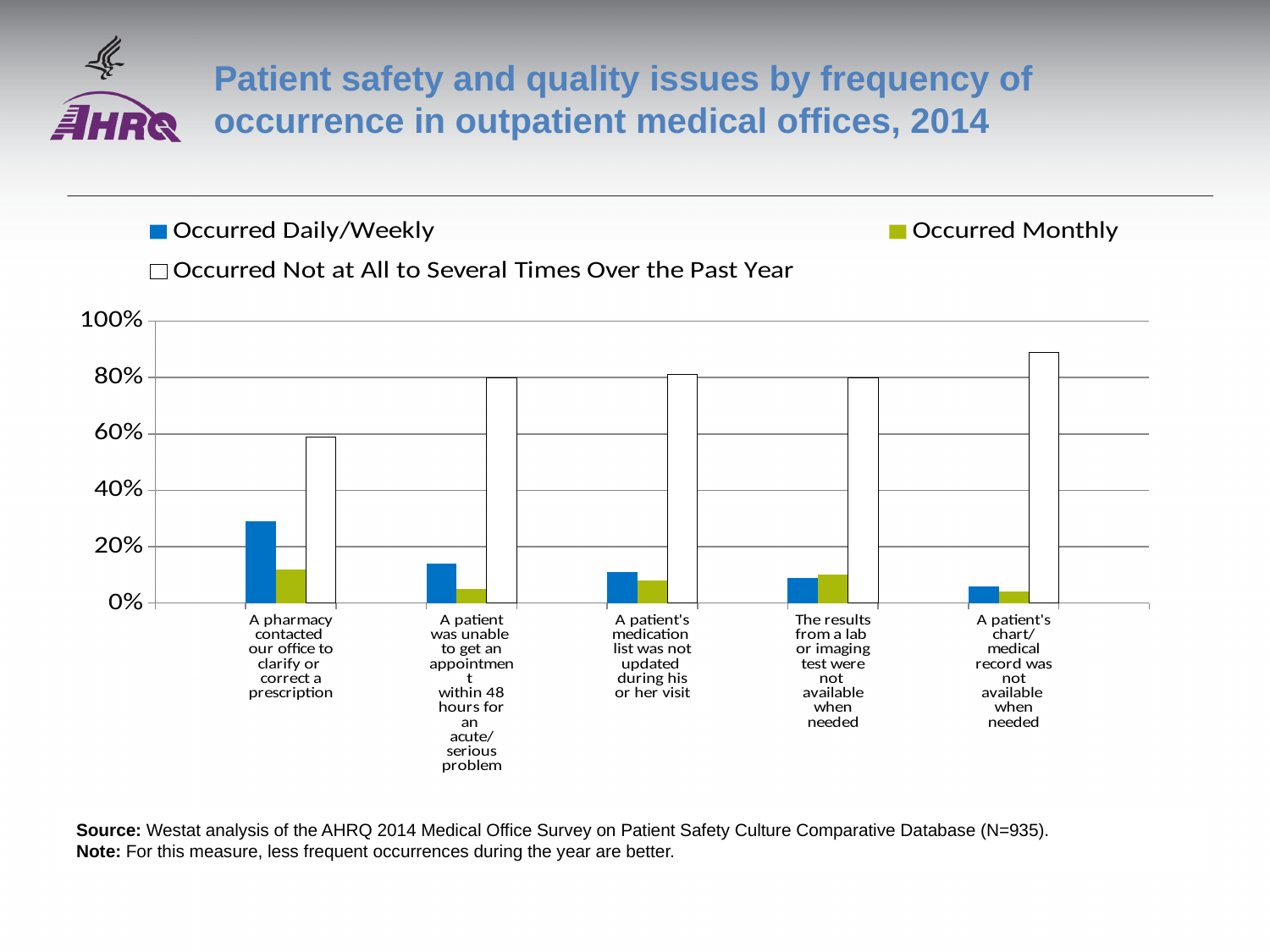
What kind of chart is shown on the slide? Bar chart Which issue has the lowest value for Occurred Daily/Weekly? A patient's chart/medical record was not available when needed How many patient safety and quality issues (categories) are shown on the x axis? 5 Which issue has the highest value for Occurred Not at All to Several Times Over the Past Year? A patient's chart/medical record was not available when needed For 'A pharmacy contacted our office to clarify or correct a prescription', which is larger: Occurred Daily/Weekly or Occurred Monthly? Occurred Daily/Weekly Is the Occurred Not at All to Several Times Over the Past Year value for 'A patient's chart/medical record was not available when needed' greater or less than 80%? greater Which issue has the highest value for Occurred Daily/Weekly? A pharmacy contacted our office to clarify or correct a prescription Is the Occurred Daily/Weekly value for 'A pharmacy contacted our office to clarify or correct a prescription' greater or less than 20%? greater What colour represents the Occurred Monthly series in the legend? Green How many series does the legend list? 3 Which issue has the lowest value for Occurred Not at All to Several Times Over the Past Year? A pharmacy contacted our office to clarify or correct a prescription Is the Occurred Not at All to Several Times Over the Past Year value for 'A patient was unable to get an appointment within 48 hours for an acute/serious problem' greater or less than 60%? greater